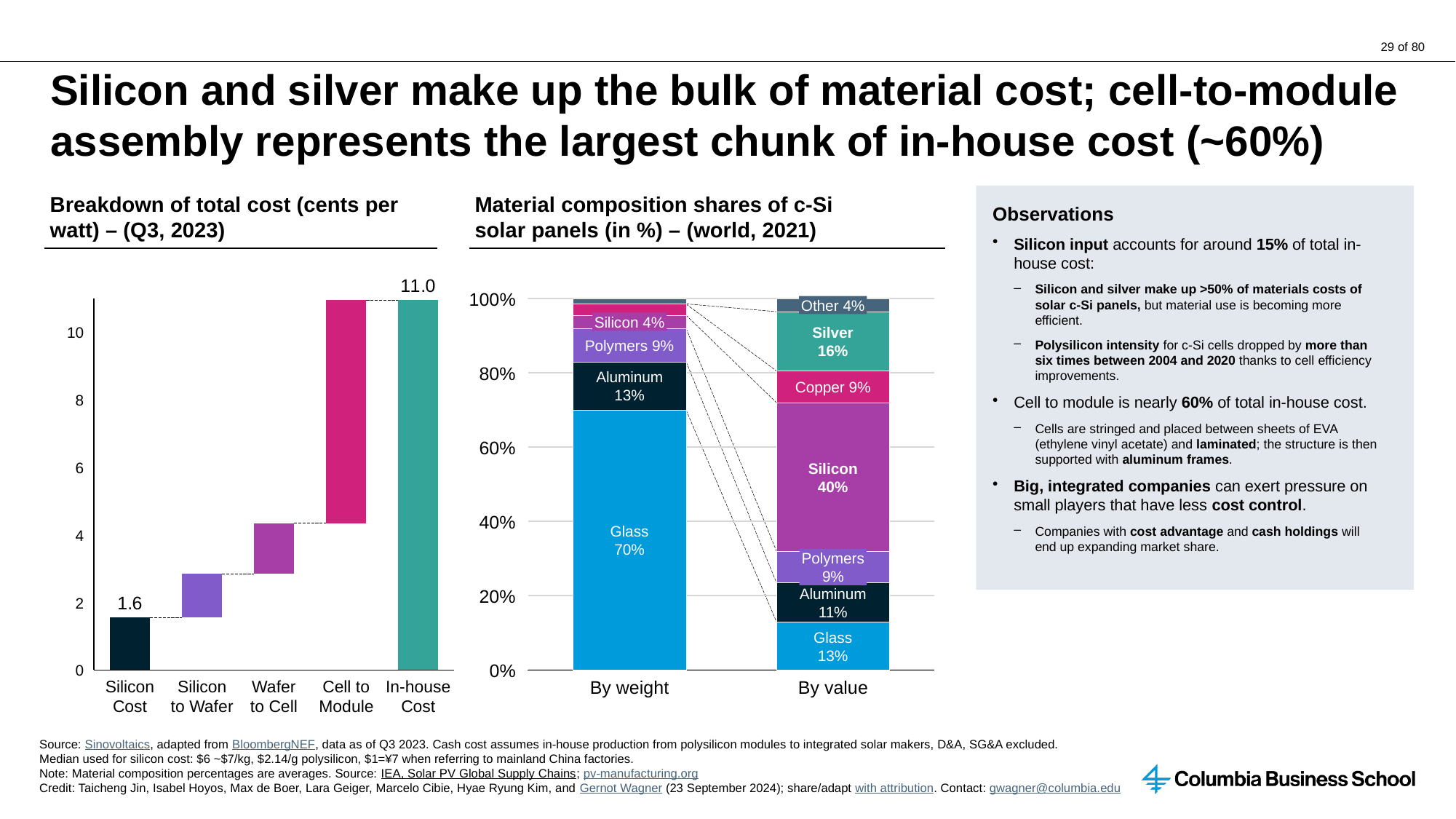
In the 'Material composition shares of c-Si solar panels' chart, what is the difference between the Glass share By weight and the Glass share By value? 57% What kind of chart is the 'Material composition shares of c-Si solar panels' chart? Stacked bar chart In the 'Material composition shares of c-Si solar panels' chart, what is the combined share of Silicon and Silver in the By value bar? 56% In the 'Breakdown of total cost (cents per watt)' chart, what is the difference between In-house Cost and Silicon Cost? 9.4 In the 'Breakdown of total cost (cents per watt)' chart, what is the value for In-house Cost? 11.0 In the 'Material composition shares of c-Si solar panels' chart, which material has the largest share in the By value bar? Silicon In the 'Material composition shares of c-Si solar panels' chart, what is the share of Silicon in the By value bar? 40% In the 'Breakdown of total cost (cents per watt)' chart, what is the value for Silicon Cost? 1.6 How many categories are shown on the x axis of the 'Breakdown of total cost (cents per watt)' chart? 5 In the 'Material composition shares of c-Si solar panels' chart, which is larger in the By value bar: Silver or Copper? Silver In the 'Material composition shares of c-Si solar panels' chart, what is the share of Silver in the By value bar? 16% In the 'Material composition shares of c-Si solar panels' chart, what is the share of Glass in the By weight bar? 70%